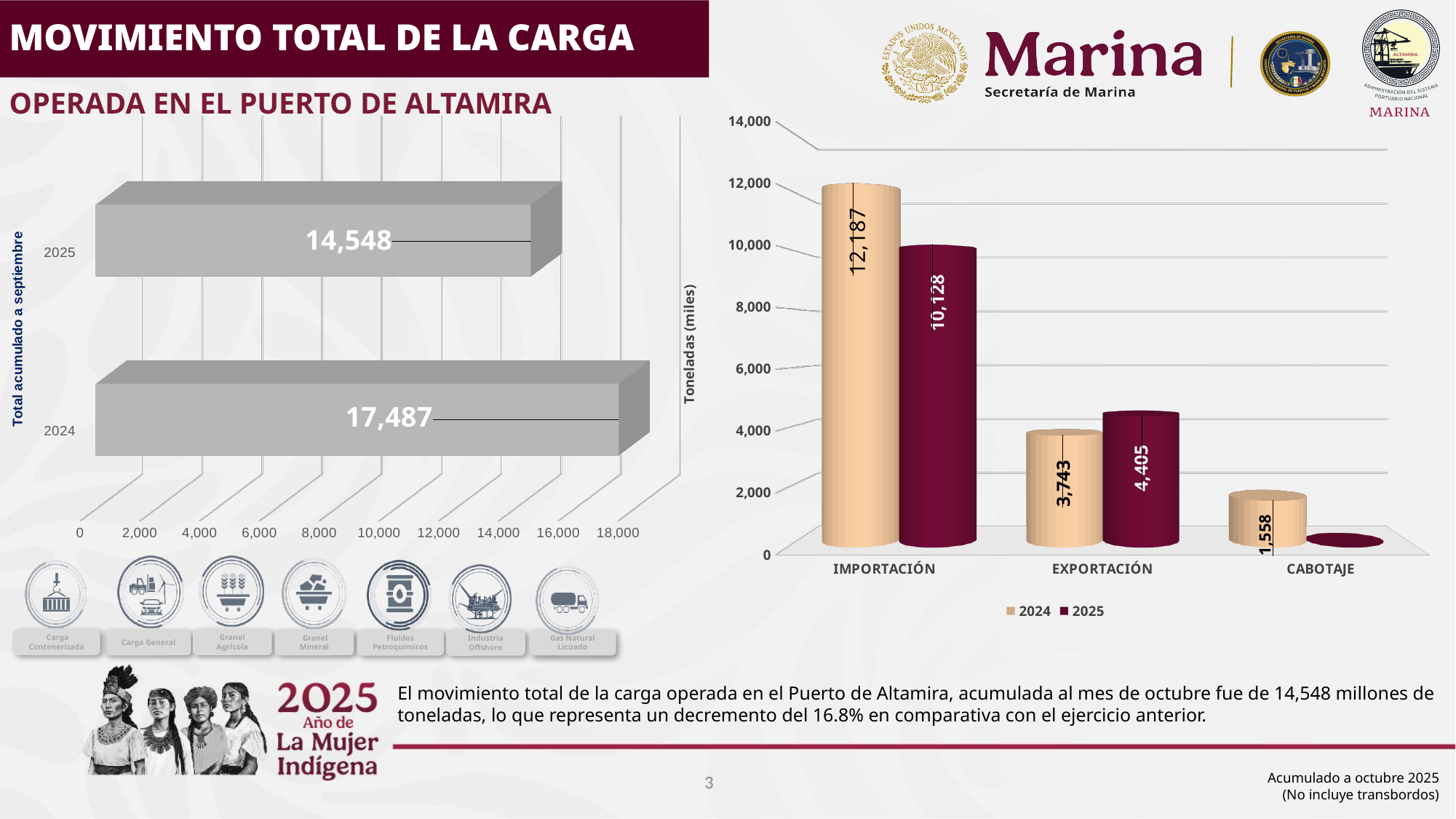
In the right chart, which category has the highest 2025 value? Importación In the right chart, what is the difference between the 2024 and 2025 values for Importación? 2,059 In the right chart, what is the 2024 value for Cabotaje? 1,558 In the left chart, what is the difference between the 2024 and 2025 values? 2,939 In the left chart, which year has the larger value, 2024 or 2025? 2024 In the right chart, how many series does the legend list? 2 In the left chart, what is the value for 2024? 17,487 In the right chart, what is the 2025 value for Exportación? 4,405 In the left chart, what is the value for 2025? 14,548 What kind of chart is the left chart? Bar chart In the right chart, how many categories are shown on the x axis? 3 In the right chart, what is the 2024 value for Importación? 12,187